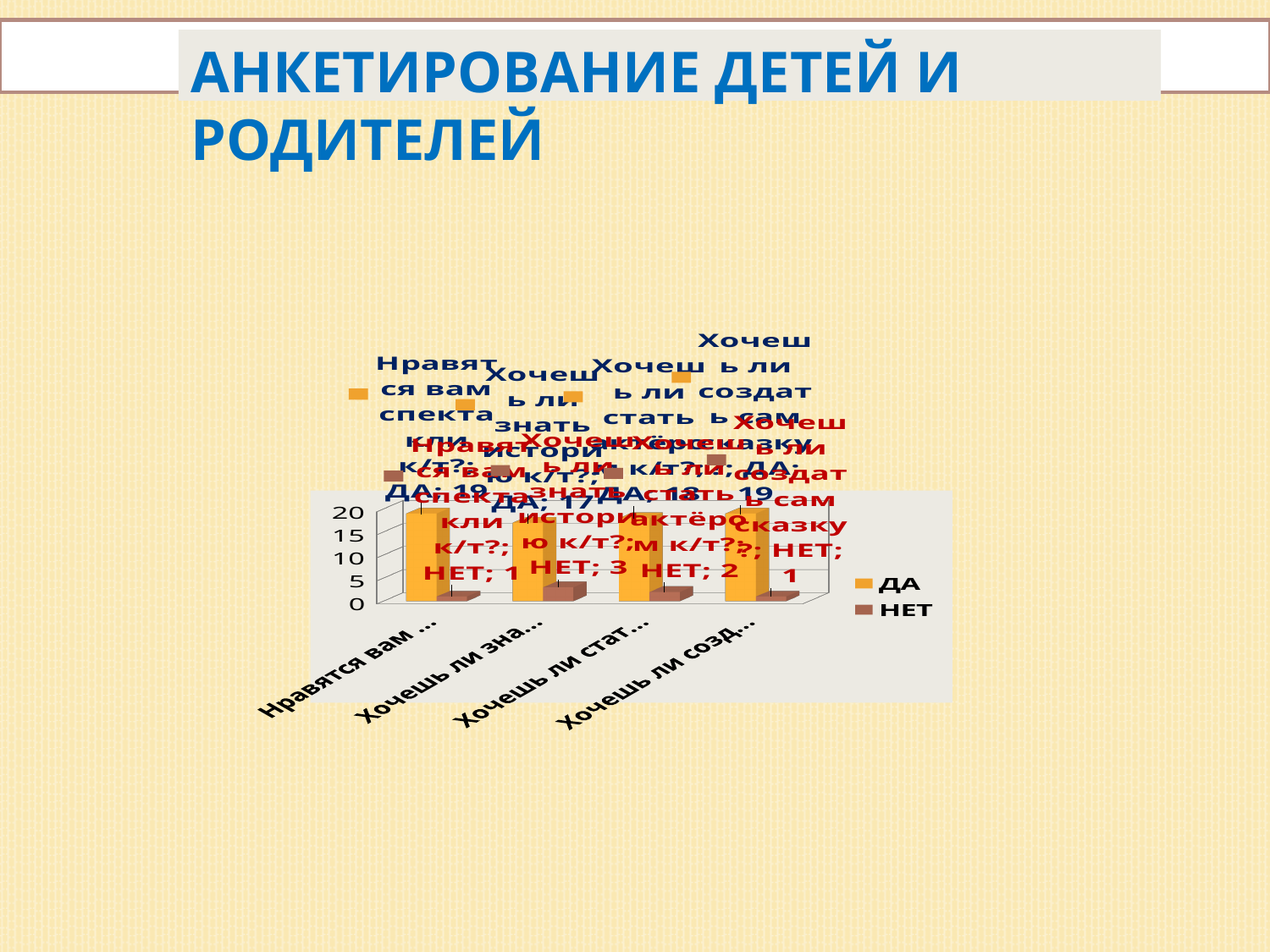
Which is larger for the third category, "Хочешь ли стат...": the ДА value or the НЕТ value? ДА How many series does the chart legend list? 2 What is the ДА value for the first category, "Нравятся вам ..."? 19 Which category has the lowest ДА value? Хочешь ли зна... What is the ДА value for the second category, "Хочешь ли зна..."? 17 What are the two series named in the chart legend? ДА and НЕТ What is the НЕТ value for the second category, "Хочешь ли зна..."? 3 Which category has the highest НЕТ value? Хочешь ли зна... How many categories are shown on the chart's x axis? 4 What kind of chart is shown on the slide? bar chart What is the difference between the ДА and НЕТ values for the second category, "Хочешь ли зна..."? 14 What is the НЕТ value for the third category, "Хочешь ли стат..."? 2